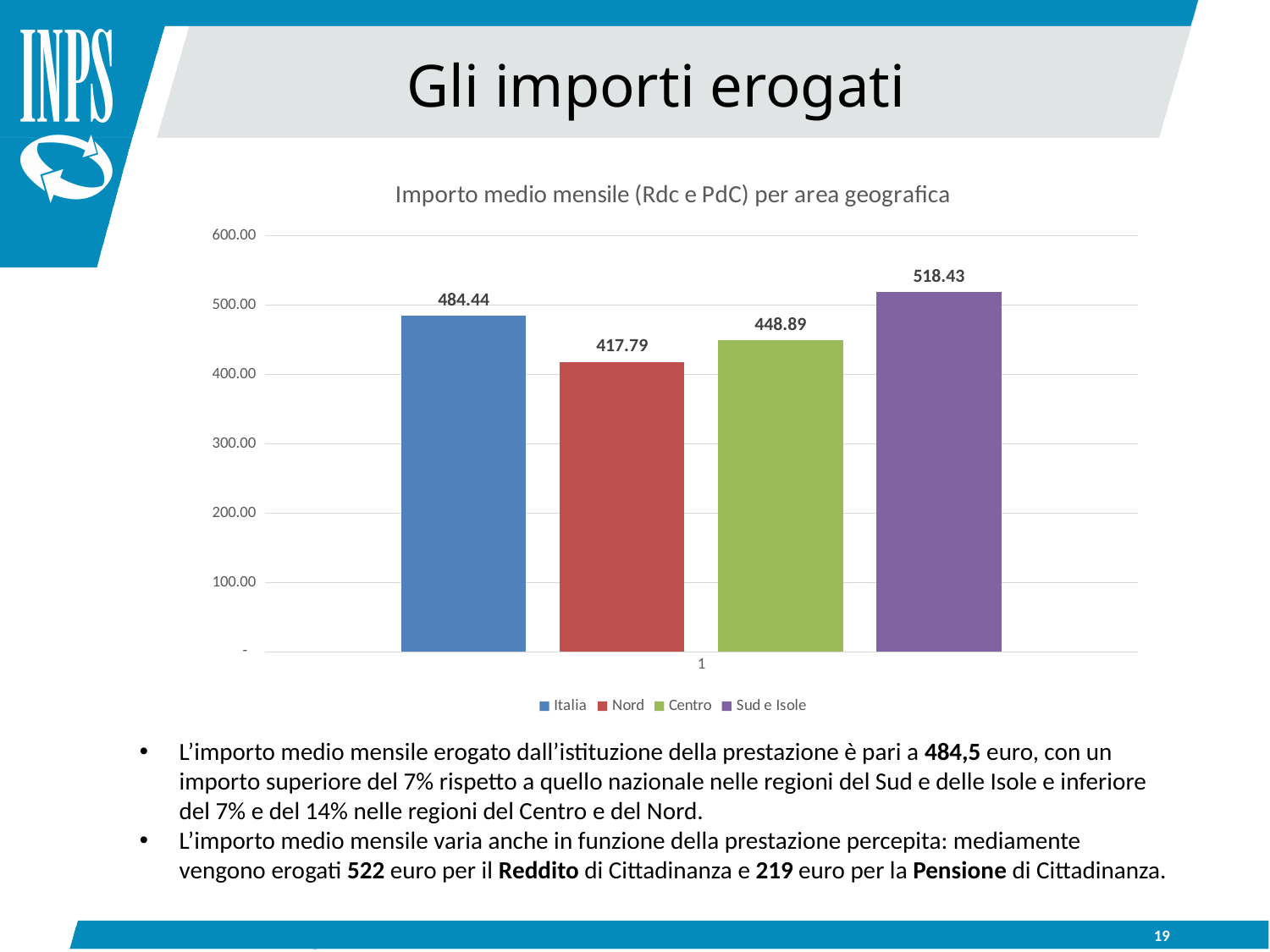
Which is larger, the value for Centro or the value for Nord? Centro How many series does the legend list? 4 What is the difference between the values for Sud e Isole and Nord? 100.64 What is the title of the chart? Importo medio mensile (Rdc e PdC) per area geografica What is the value for Sud e Isole in the chart? 518.43 What is the value for Centro in the chart? 448.89 What is the value for Italia in the chart? 484.44 Which area has the lowest value in the chart? Nord What is the value for Nord in the chart? 417.79 Is the value for Sud e Isole greater or less than 500.00? greater Which area has the highest value in the chart? Sud e Isole What is the difference between the values for Italia and Centro? 35.55